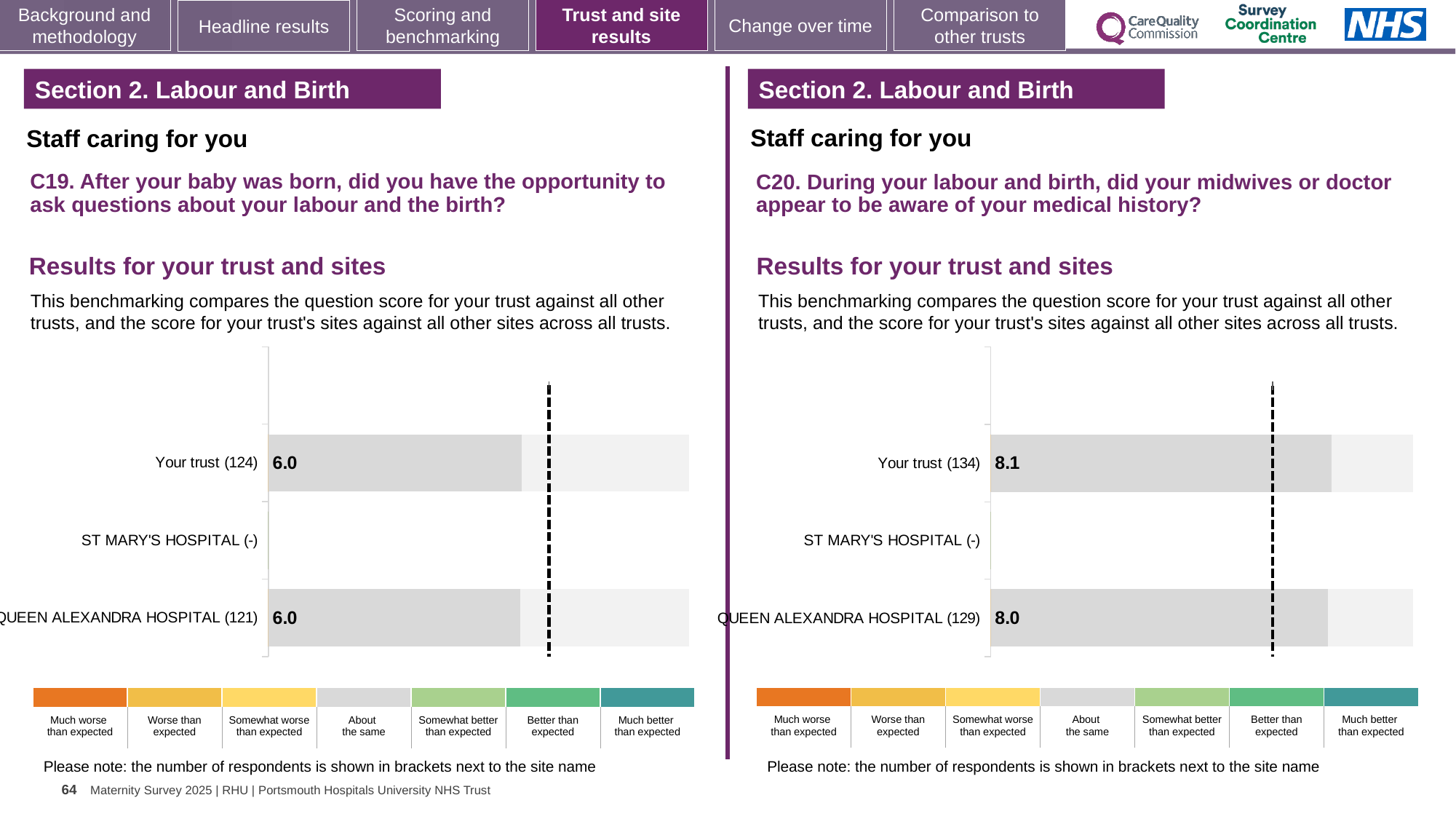
What kind of chart is used in the C20 chart on the right? Bar chart In the C19 chart on the left, what is the score for Queen Alexandra Hospital? 6.0 In the C19 chart on the left, how many respondents are shown in brackets for Your trust? 124 In the C19 chart on the left, which category has no score shown? ST MARY'S HOSPITAL (-) In the C20 chart on the right, what is the score for Queen Alexandra Hospital? 8.0 How many benchmark categories does the colour legend below the C19 chart on the left list? 7 In the C20 chart on the right, what is the score for Your trust? 8.1 In the C20 chart on the right, how many respondents are shown in brackets for Your trust? 134 In the C19 chart on the left, how many site or trust categories are listed on the vertical axis? 3 In the C20 chart on the right, what is the difference between the score for Your trust and the score for Queen Alexandra Hospital? 0.1 In the C19 chart on the left, what is the score for Your trust? 6.0 In the C20 chart on the right, how many respondents are shown in brackets for Queen Alexandra Hospital? 129